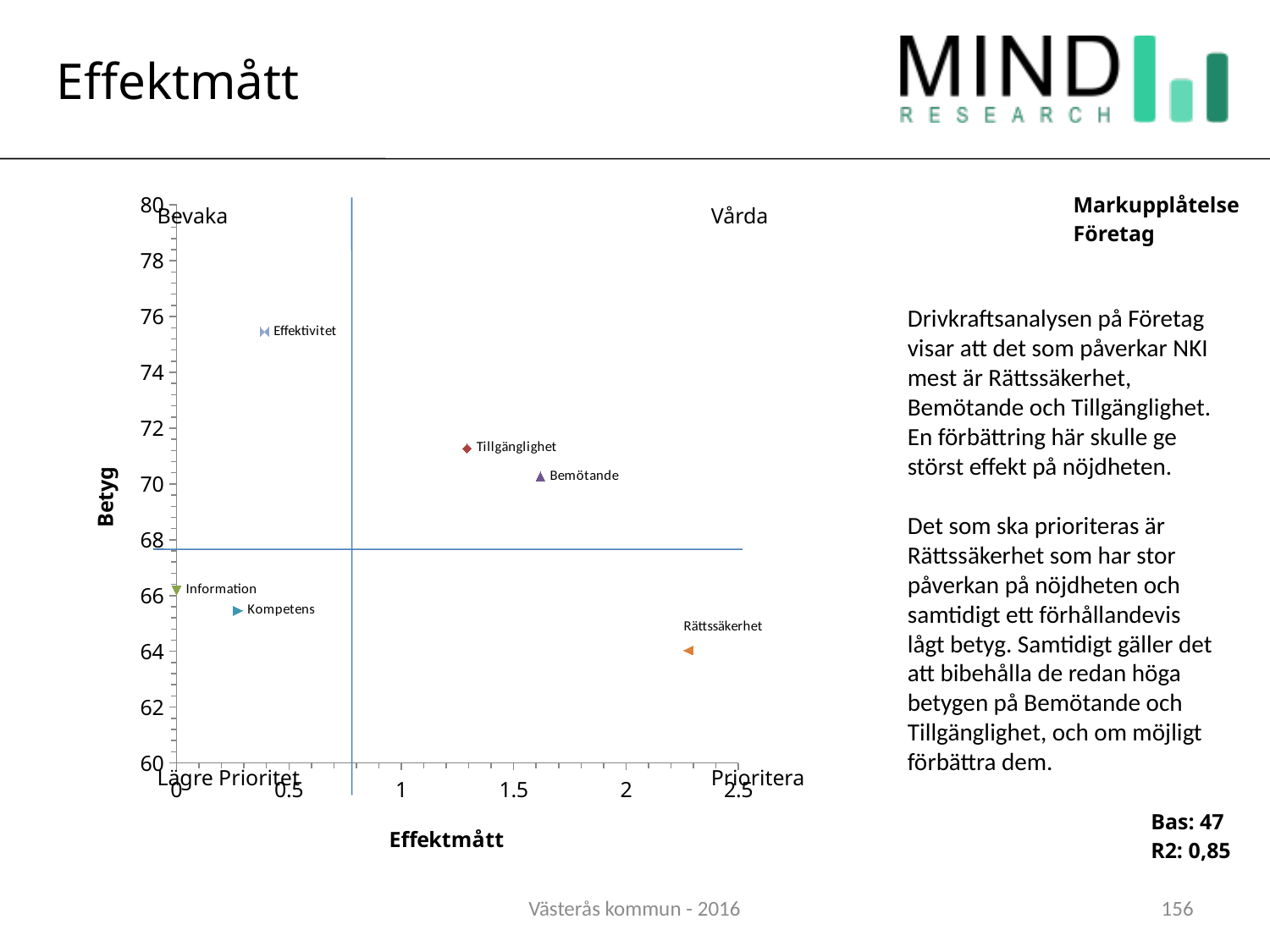
What is the title of the horizontal axis of the chart? Effektmått Which has a higher Effektmått value, Bemötande or Tillgänglighet? Bemötande Which point has the lowest Betyg value? Rättssäkerhet What kind of chart is shown on the slide? scatter chart Which point has the highest Effektmått value? Rättssäkerhet Is the Effektmått value for Rättssäkerhet greater or less than 2? greater Which point has the highest Betyg value? Effektivitet Which point has the lowest Effektmått value? Information Which has a higher Betyg value, Tillgänglighet or Bemötande? Tillgänglighet Is the Betyg value for Effektivitet greater or less than 74? greater Is the Betyg value for Tillgänglighet greater or less than 70? greater How many data points are plotted in the chart? 6